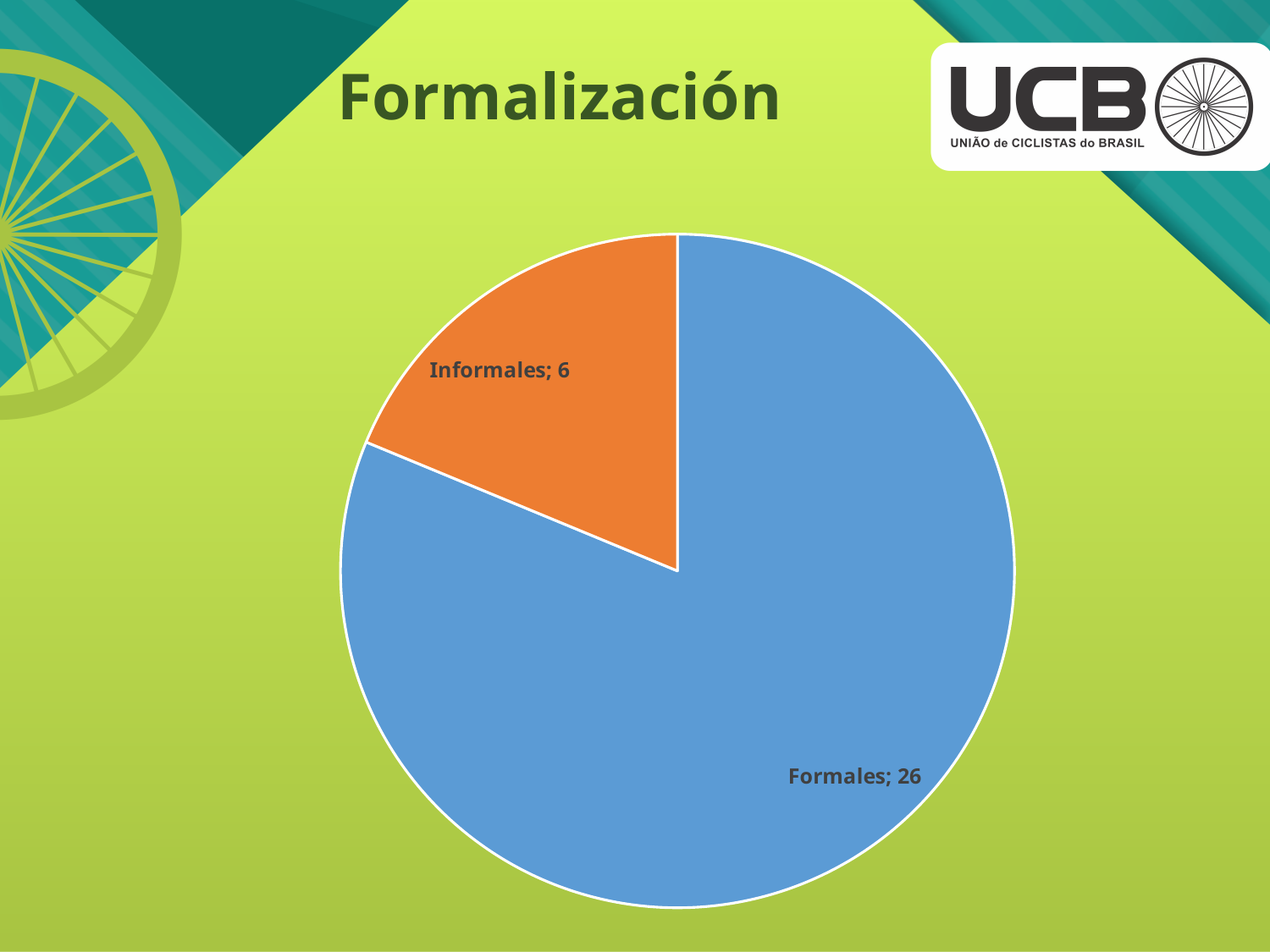
What kind of chart is shown on the slide? Pie chart What is the total of all slices in the pie chart? 32 What is the difference between the Formales and Informales values? 20 Which is larger, Formales or Informales? Formales What is the value for Informales? 6 What colour is the Informales slice? Orange What is the value for Formales? 26 What share of the pie does Informales represent? 18.75% How many slices does the pie chart have? 2 Which category has the smallest slice? Informales Which category has the largest slice? Formales What share of the pie does Formales represent? 81.25%